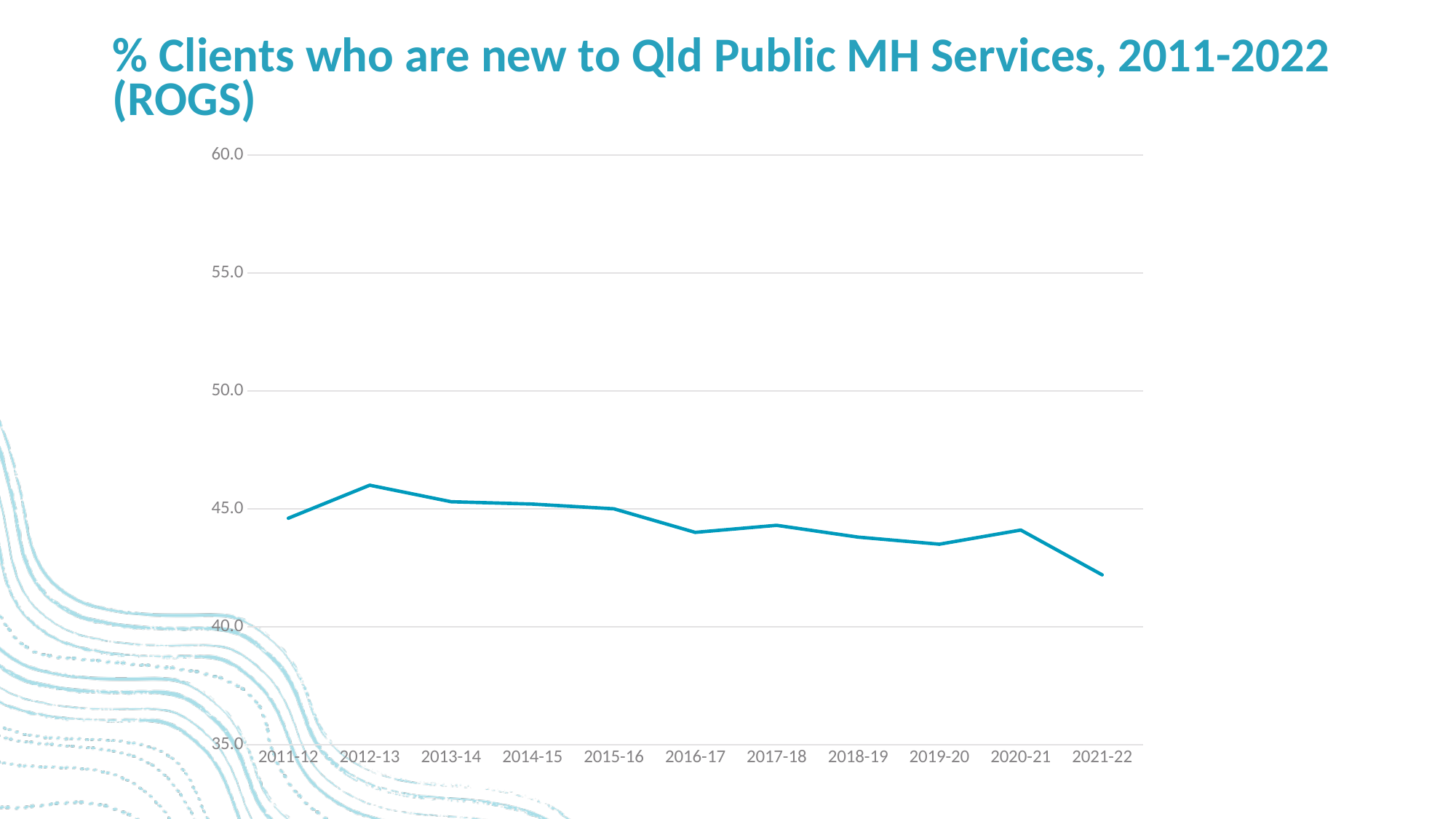
Overall, does the percentage of new clients rise or fall from 2011-12 to 2021-22? Fall Is the value for 2021-22 greater or less than 45.0? less What is the title of the chart? % Clients who are new to Qld Public MH Services, 2011-2022 (ROGS) Which is larger, the value for 2012-13 or the value for 2021-22? 2012-13 How many financial years are plotted along the x axis? 11 Is the value for 2012-13 greater or less than 45.0? greater Is the value for 2016-17 greater or less than 45.0? less Which year has the lowest percentage of clients new to Qld Public MH Services? 2021-22 What kind of chart is shown on the slide? Line chart Which is larger, the value for 2019-20 or the value for 2020-21? 2020-21 Which year has the highest percentage of clients new to Qld Public MH Services? 2012-13